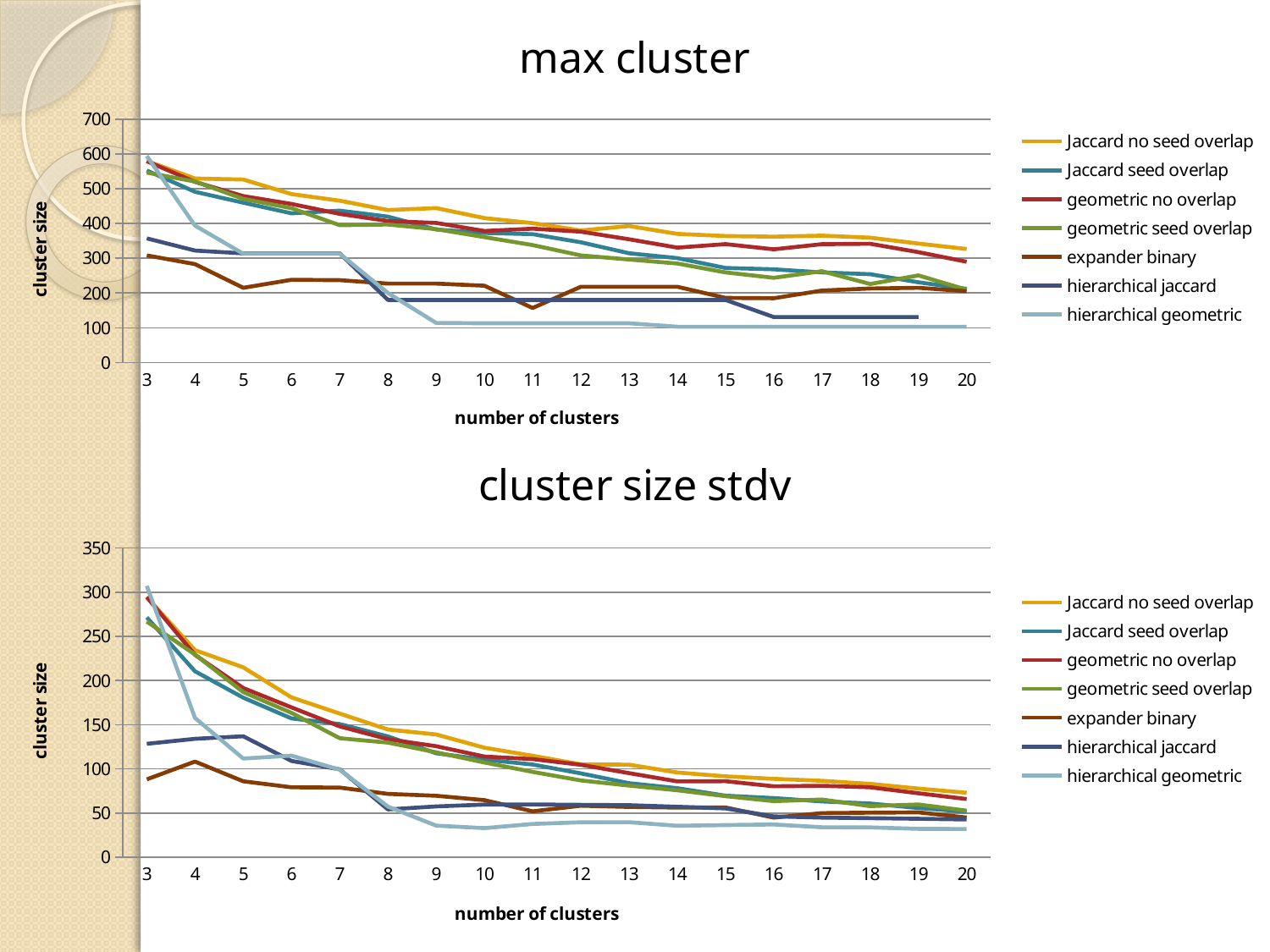
In the "max cluster" chart, which series has the lowest value at 20 clusters? hierarchical geometric How many series does the legend of the "cluster size stdv" chart list? 7 In the "cluster size stdv" chart, which is larger at 20 clusters: "Jaccard no seed overlap" or "hierarchical geometric"? Jaccard no seed overlap What is the label of the x axis on the "cluster size stdv" chart? number of clusters In the "max cluster" chart, does the "Jaccard no seed overlap" series rise or fall as the number of clusters increases? fall In the "cluster size stdv" chart, does the "geometric no overlap" series rise or fall as the number of clusters increases? fall In the "max cluster" chart, which series has the highest value at 20 clusters? Jaccard no seed overlap In the "max cluster" chart, is the value for "expander binary" at 5 clusters greater or less than 300? less In the "max cluster" chart, is the value for "hierarchical geometric" at 9 clusters greater or less than 200? less What kind of chart is the "max cluster" chart? line chart In the "cluster size stdv" chart, is the value for "hierarchical jaccard" at 3 clusters greater or less than 100? greater How many values of "number of clusters" are plotted along the x axis of the "max cluster" chart? 18